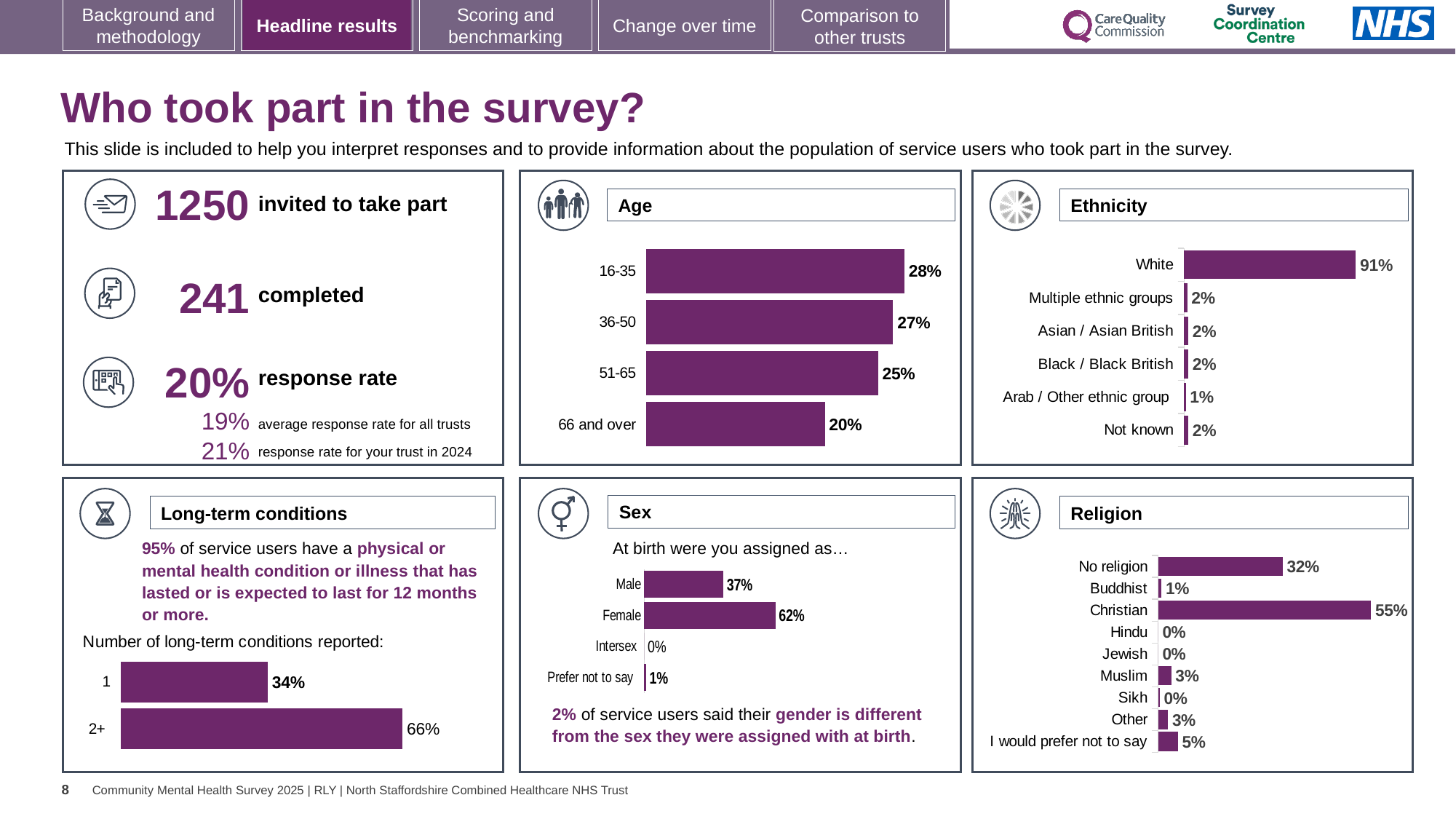
What type of chart is used in the Age panel? Bar chart In the Religion chart, what percentage of respondents said they had no religion? 32% In the Age chart, which age group has the lowest percentage? 66 and over In the Age chart, what is the difference between the 36-50 and 51-65 percentages? 2% In the Age chart, what percentage of respondents were aged 16-35? 28% In the Ethnicity chart, what percentage of respondents were White? 91% In the Sex chart, what is the difference between the Female and Male percentages? 25% In the Religion chart, which religion category has the highest percentage? Christian In the Ethnicity chart, how many ethnicity categories are shown? 6 In the Long-term conditions chart, what percentage of service users reported 2+ long-term conditions? 66% In the Ethnicity chart, what is the value for Arab / Other ethnic group? 1% In the Sex chart, which is larger, Male or Female? Female